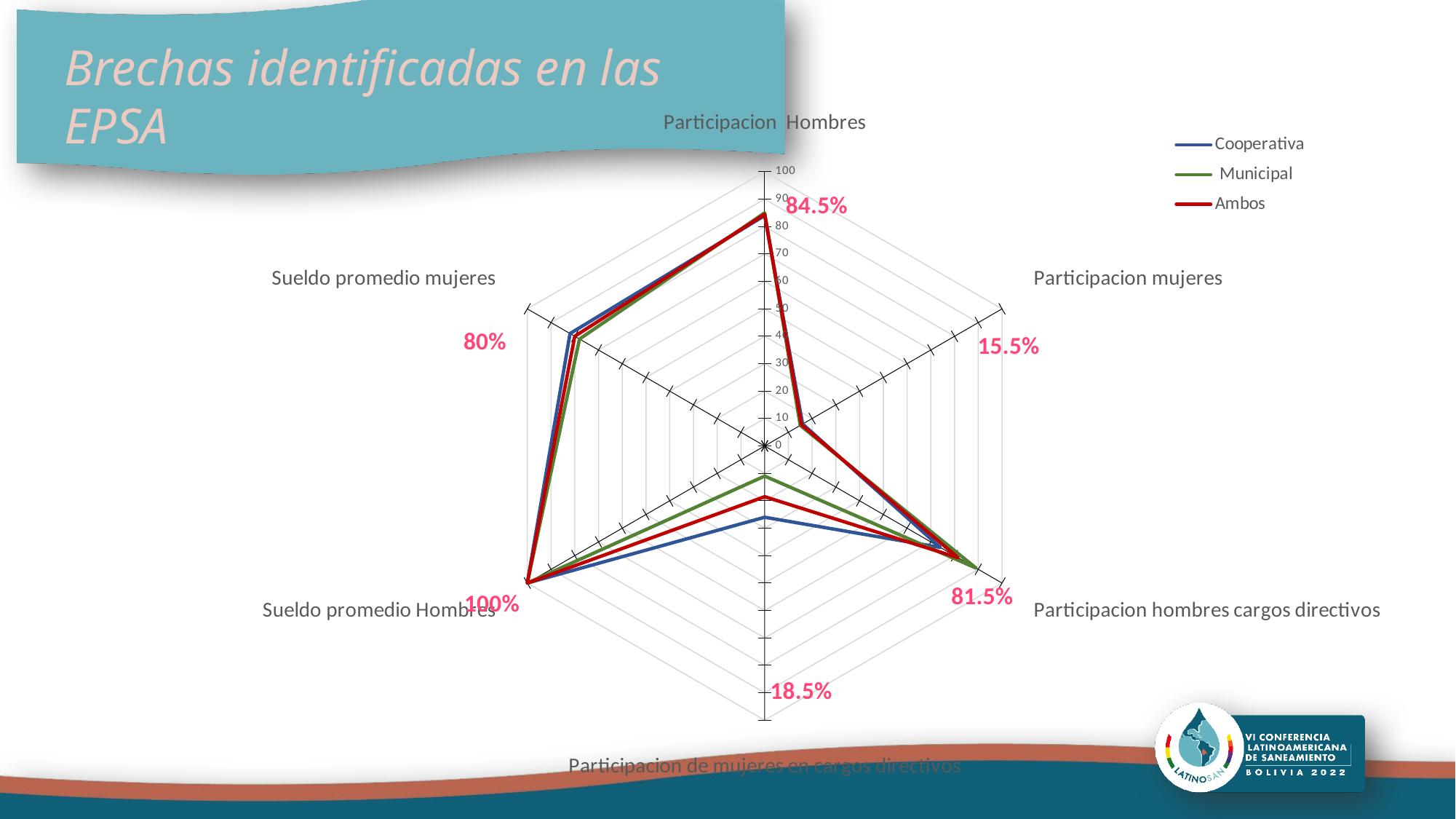
How many series does the legend of the radar chart list? 3 What is the difference between the labelled values for Participacion Hombres and Participacion mujeres? 69% How many categories (axes) does the radar chart have? 6 What is the title of the slide containing the radar chart? Brechas identificadas en las EPSA Is the Cooperativa value on the Participacion de mujeres en cargos directivos axis greater or less than 20? greater Which labelled category on the radar chart has the lowest value? Participacion mujeres What are the three series named in the legend of the radar chart? Cooperativa, Municipal, Ambos What value is labelled on the Sueldo promedio Hombres axis of the radar chart? 100% What kind of chart is shown on the slide? radar chart What value is labelled on the Participacion mujeres axis of the radar chart? 15.5% On the Participacion de mujeres en cargos directivos axis, which series has the larger value, Cooperativa or Municipal? Cooperativa What value is labelled on the Participacion Hombres axis of the radar chart? 84.5%